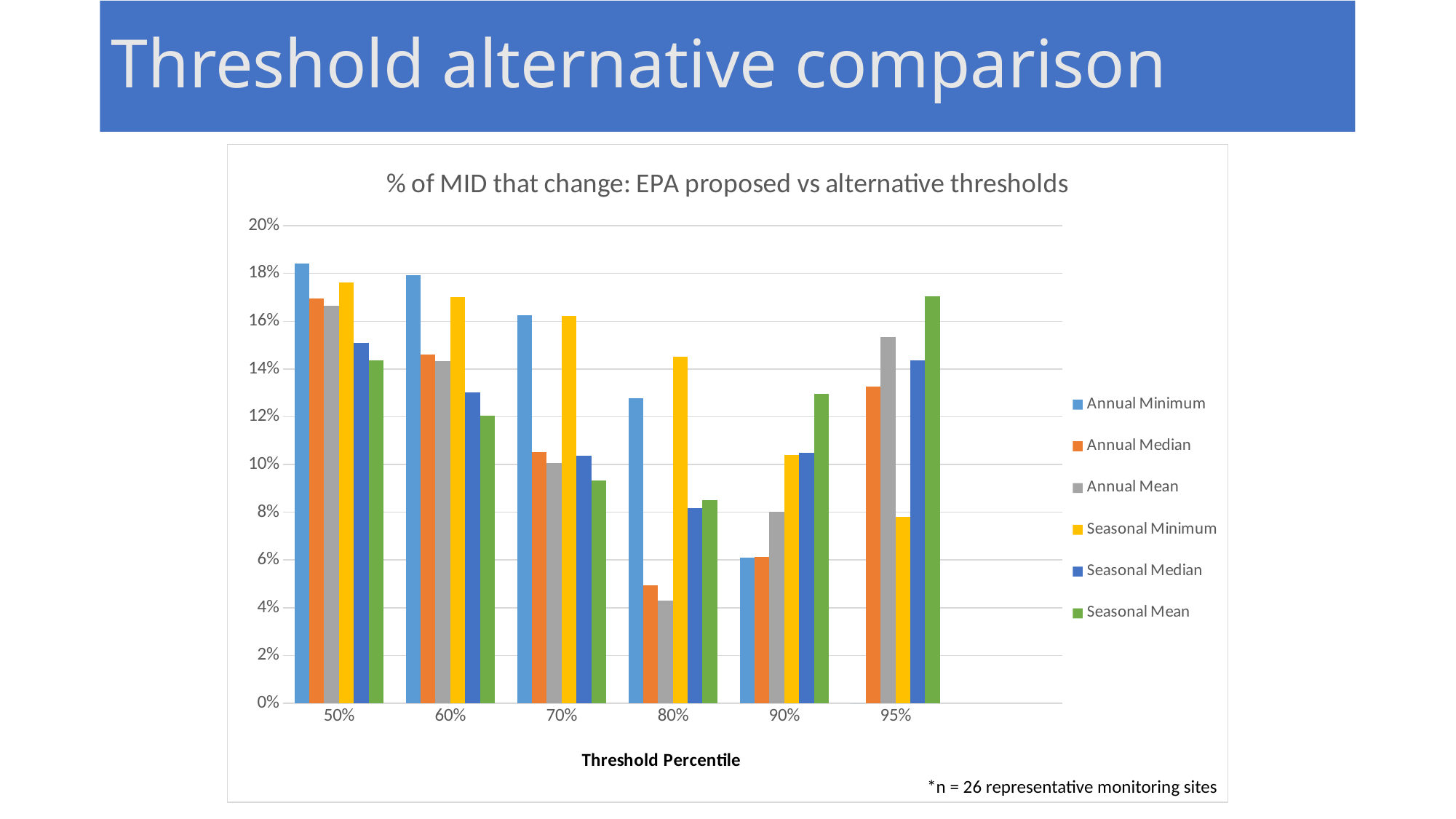
At the 80% threshold percentile, which is larger: Seasonal Minimum or Annual Minimum? Seasonal Minimum Is the Seasonal Minimum value at the 90% threshold percentile greater or less than 8%? greater How many threshold percentile categories are shown on the x axis? 6 At which threshold percentile is the Annual Minimum value highest? 50% Does the Annual Minimum value rise or fall from the 50% to the 90% threshold percentile? Fall What kind of chart is shown on the slide? Bar chart How many series does the legend list? 6 Which series has the lowest value at the 80% threshold percentile? Annual Mean Is the Annual Mean value at the 80% threshold percentile greater or less than 6%? less What is the title of the x axis? Threshold Percentile Which series has the highest value at the 95% threshold percentile? Seasonal Mean Is the Seasonal Mean value at the 95% threshold percentile greater or less than 16%? greater